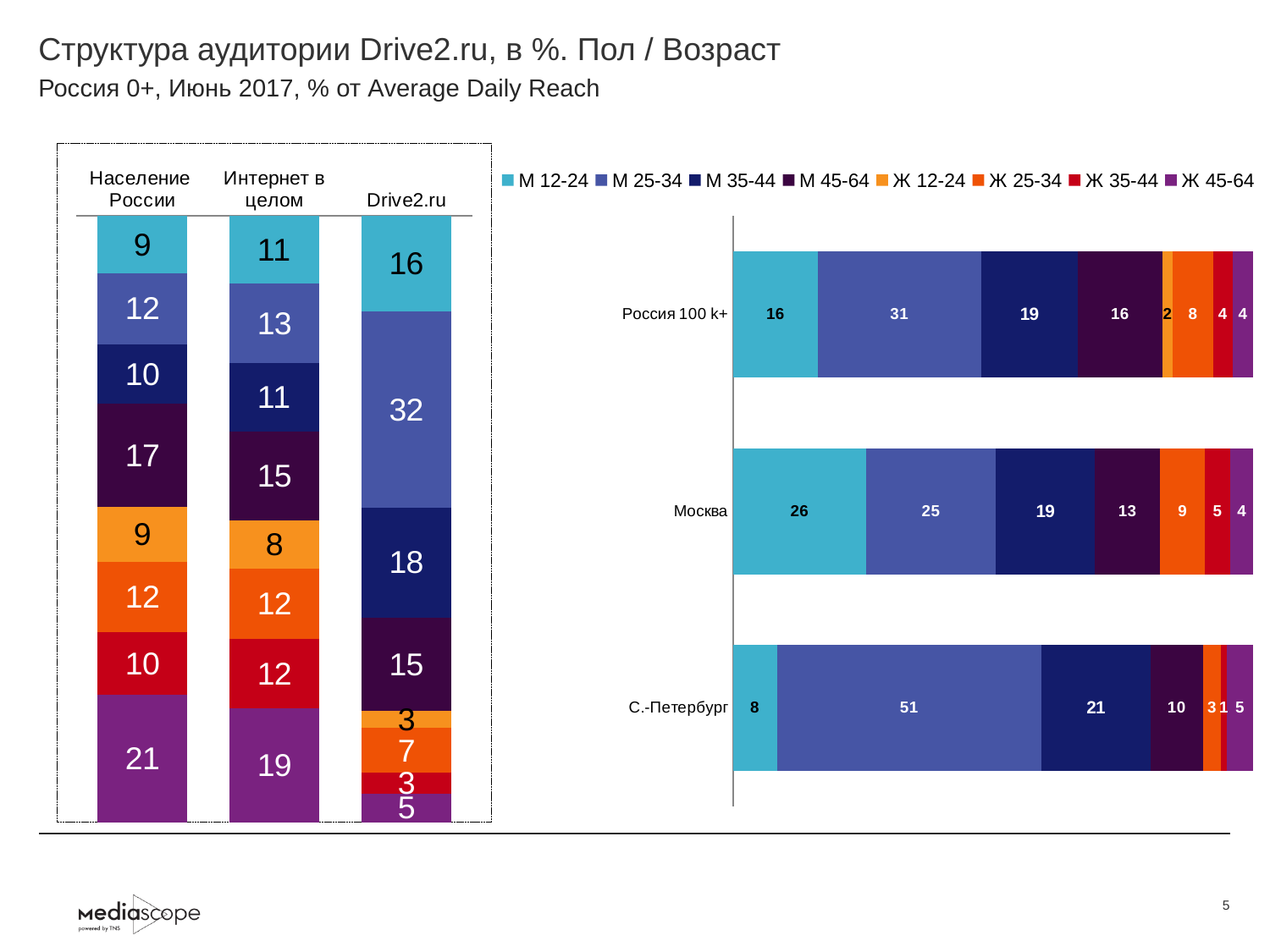
In the left chart, what is the value of the М 25-34 segment for Drive2.ru? 32 In the left chart, what is the value of the М 45-64 segment for Интернет в целом? 15 What kind of chart is the right chart? Stacked bar chart In the right chart, what is the value of the М 25-34 segment for С.-Петербург? 51 In the right chart, what is the value of the М 35-44 segment for Россия 100 k+? 19 How many series does the legend on the slide list? 8 In the right chart, which category has the highest М 25-34 value? С.-Петербург How many categories (bars) are shown in the right chart? 3 In the left chart, what is the value of the Ж 45-64 segment for Население России? 21 In the right chart, what is the value of the М 12-24 segment for Москва? 26 In the left chart, what is the difference between the М 25-34 value for Drive2.ru and the М 25-34 value for Население России? 20 In the right chart, which has the larger М 12-24 value, Москва or Россия 100 k+? Москва